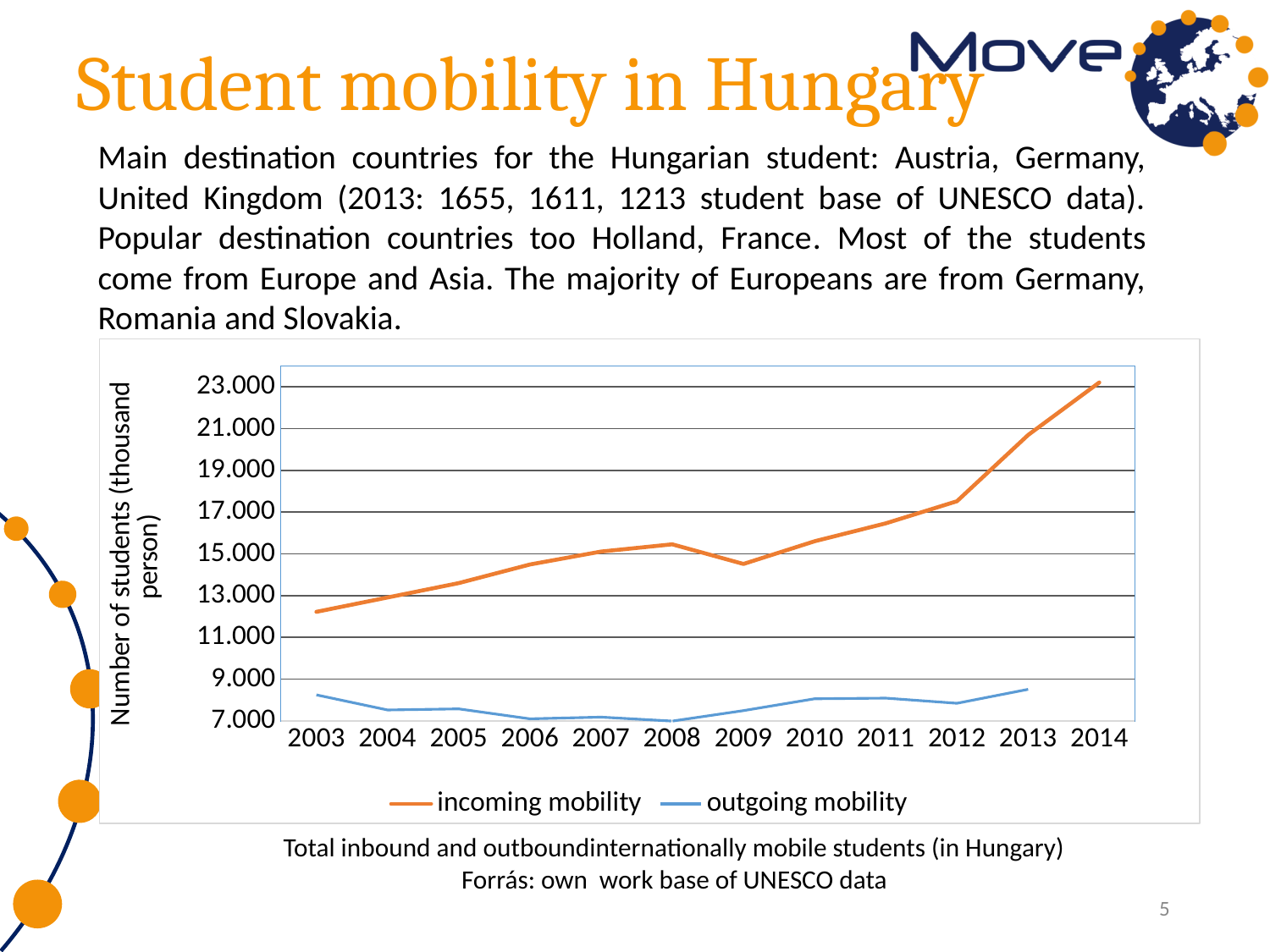
In which year is incoming mobility highest? 2014 Which series has the larger value in 2010, incoming mobility or outgoing mobility? incoming mobility Does incoming mobility generally rise or fall from 2003 to 2014? rise Is the value for outgoing mobility in 2003 greater or less than 9.000? less Is the value for incoming mobility in 2014 greater or less than 21.000? greater Is the value for incoming mobility in 2013 greater or less than 19.000? greater In which year is incoming mobility lowest? 2003 Which is larger for incoming mobility: the value in 2008 or the value in 2009? 2008 What kind of chart is shown on the slide? line chart How many series does the chart legend list? 2 How many years are shown along the x axis of the chart? 12